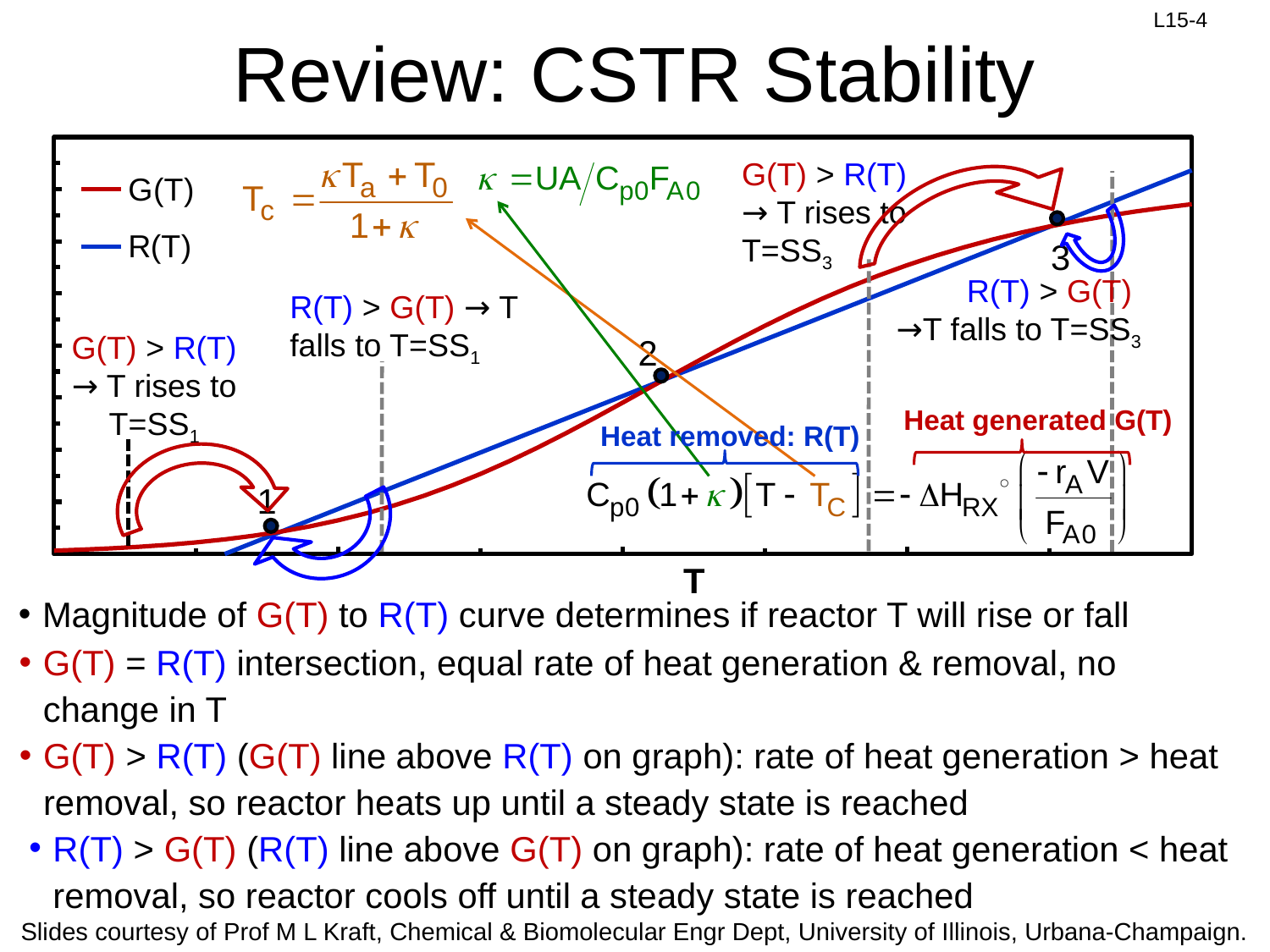
Does the G(T) curve rise or fall as T increases along the x axis? rise What kind of chart is shown on the slide? line chart Does the R(T) line rise or fall as T increases along the x axis? rise To the left of steady state 1, which curve is higher, G(T) or R(T)? G(T) How many series does the chart's legend list? 2 Between steady states 1 and 2, which curve is higher, G(T) or R(T)? R(T) Which of the two plotted series is a straight line, G(T) or R(T)? R(T) How many steady-state intersection points are marked on the chart? 3 What are the two series named in the chart's legend? G(T) and R(T) What is the label on the x axis of the chart? T